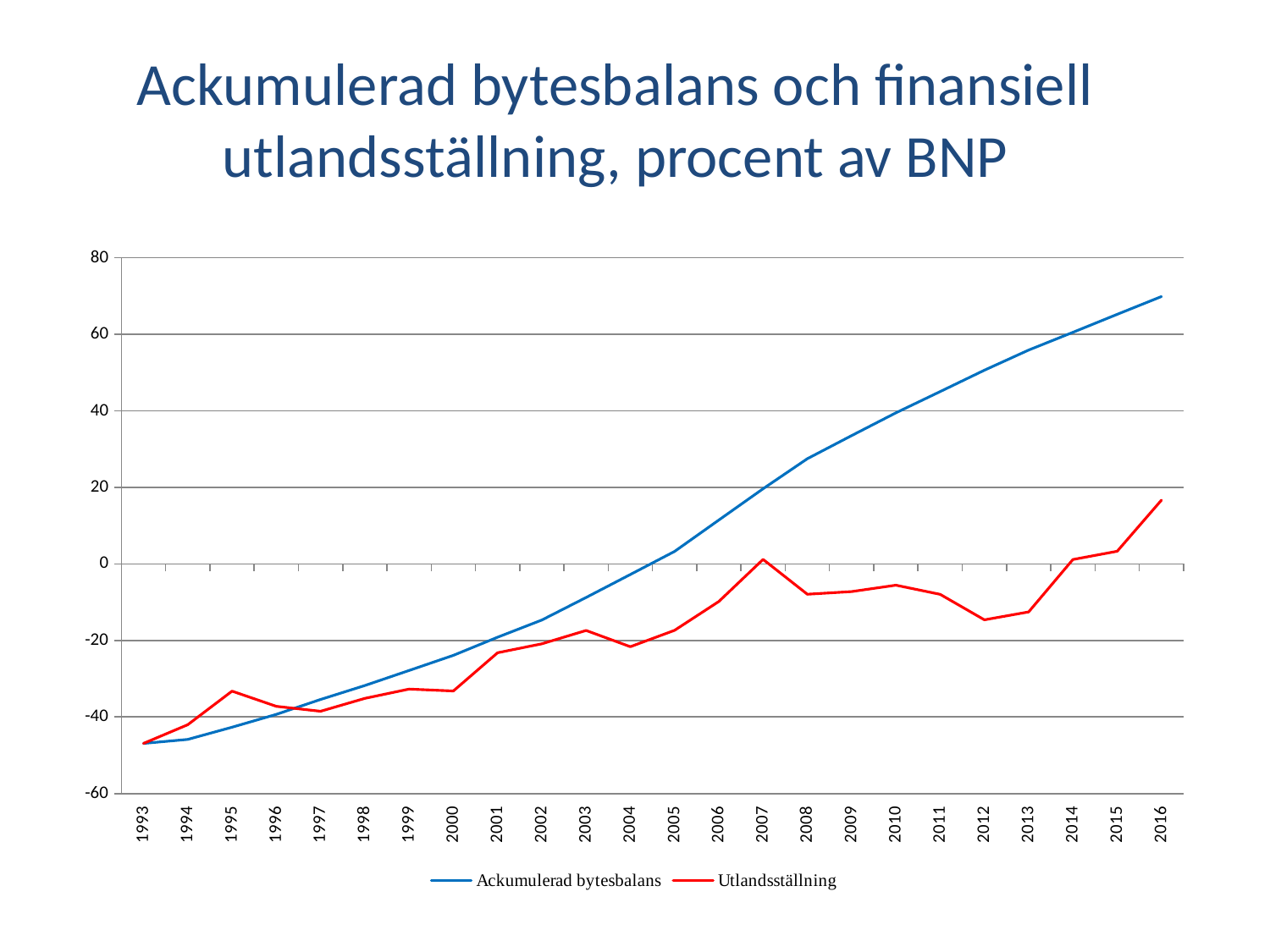
Is the value for Utlandsställning in 2016 greater or less than 0? greater In 1995, which series has the higher value, Ackumulerad bytesbalans or Utlandsställning? Utlandsställning What kind of chart is shown on the slide? line chart Is the value for Utlandsställning in 2007 greater or less than -10? greater In which year is Ackumulerad bytesbalans at its highest? 2016 Is the value for Ackumulerad bytesbalans in 2016 greater or less than 60? greater In 2010, which series has the higher value, Ackumulerad bytesbalans or Utlandsställning? Ackumulerad bytesbalans How many series does the legend list? 2 Does the Ackumulerad bytesbalans line rise or fall from 1993 to 2016? rise In which year is Utlandsställning at its lowest? 1993 How many years are plotted along the x axis? 24